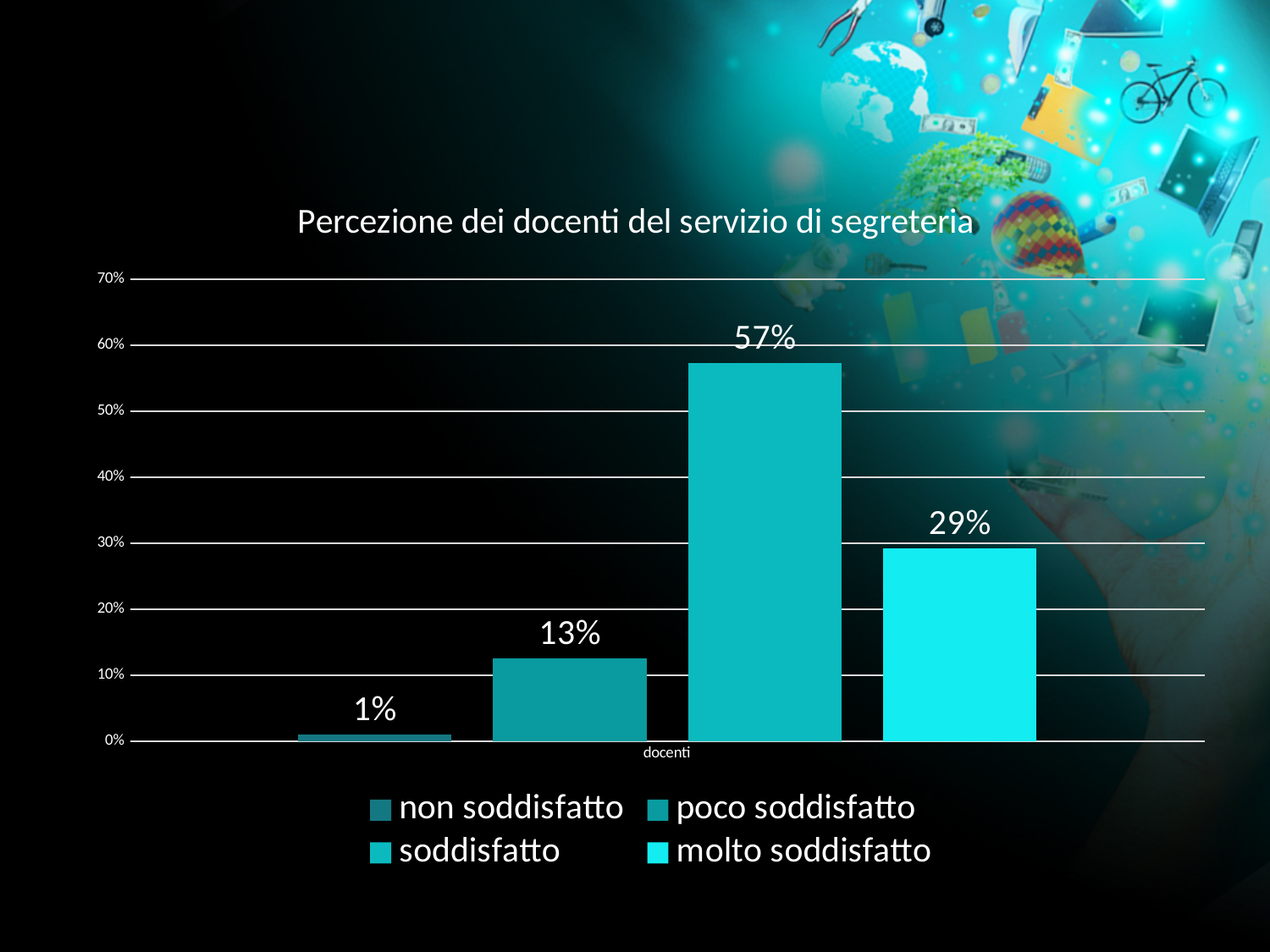
Which series has the highest value? soddisfatto What is the title of the chart? Percezione dei docenti del servizio di segreteria Is the value for "soddisfatto" greater or less than 50%? greater How many series does the legend list? 4 What is the value for "non soddisfatto"? 1% What is the value for "molto soddisfatto"? 29% What is the value for "poco soddisfatto"? 13% What kind of chart is shown on the slide? bar chart Which is larger, the value for "poco soddisfatto" or the value for "molto soddisfatto"? molto soddisfatto Which series has the lowest value? non soddisfatto What is the difference between the values for "soddisfatto" and "molto soddisfatto"? 28% What is the value for "soddisfatto"? 57%